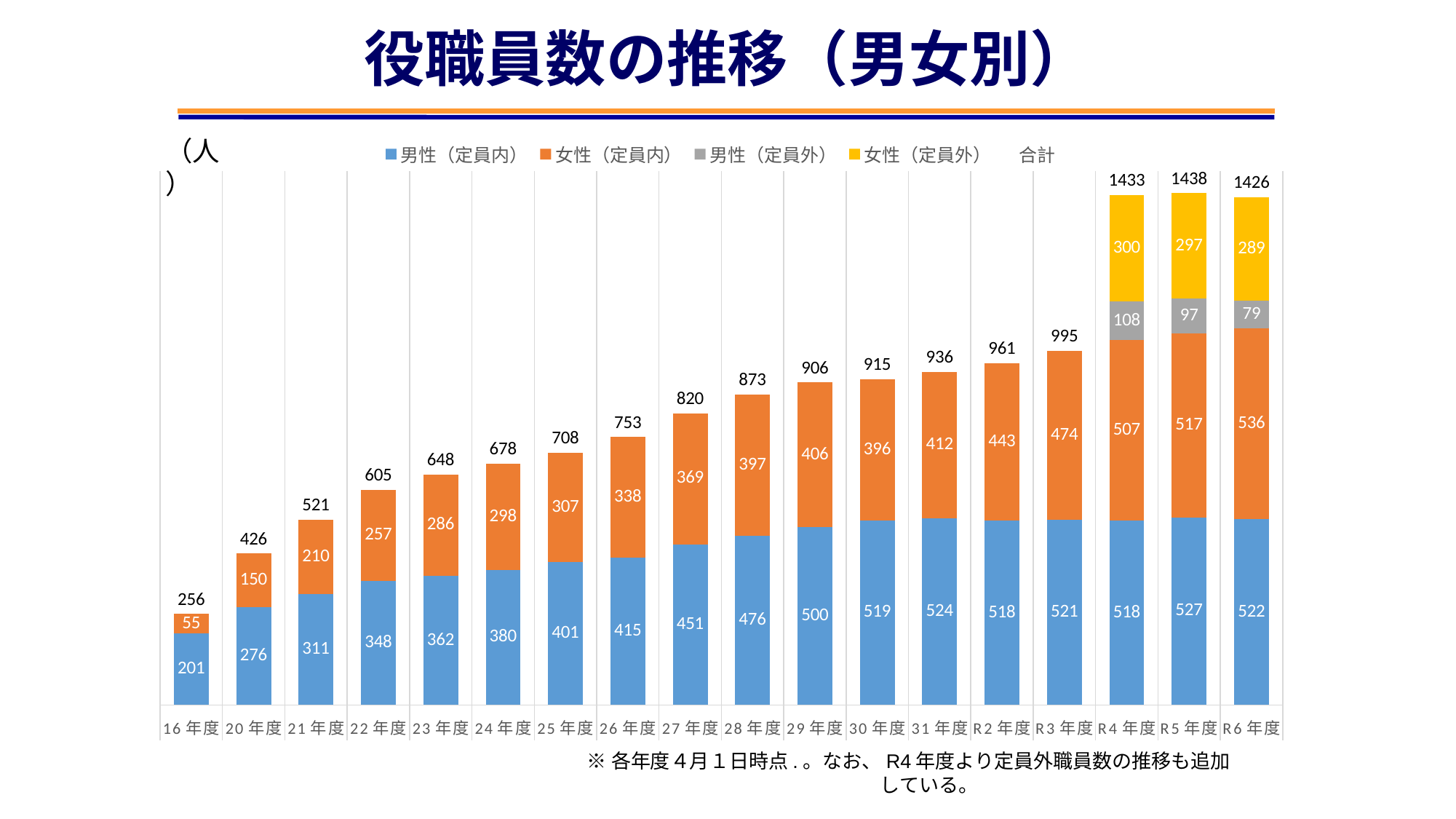
What is the value for 女性（定員外） in R4年度? 300 How many years (categories) are shown on the x axis? 18 What is the difference between the 合計 values for R6年度 and R3年度? 431 What type of chart is shown on the slide? Stacked bar chart What is the 合計 (total) value shown for 30年度? 915 Which year has the highest 合計 (total) value? R5年度 What is the value for 男性（定員内） in 27年度? 451 Which is larger: 男性（定員内） in 29年度 or 女性（定員内） in R3年度? 男性（定員内） in 29年度 Which year has the lowest 合計 (total) value? 16年度 What is the title of the chart? 役職員数の推移（男女別） How many series does the legend list? 5 What is the value for 女性（定員内） in R5年度? 517